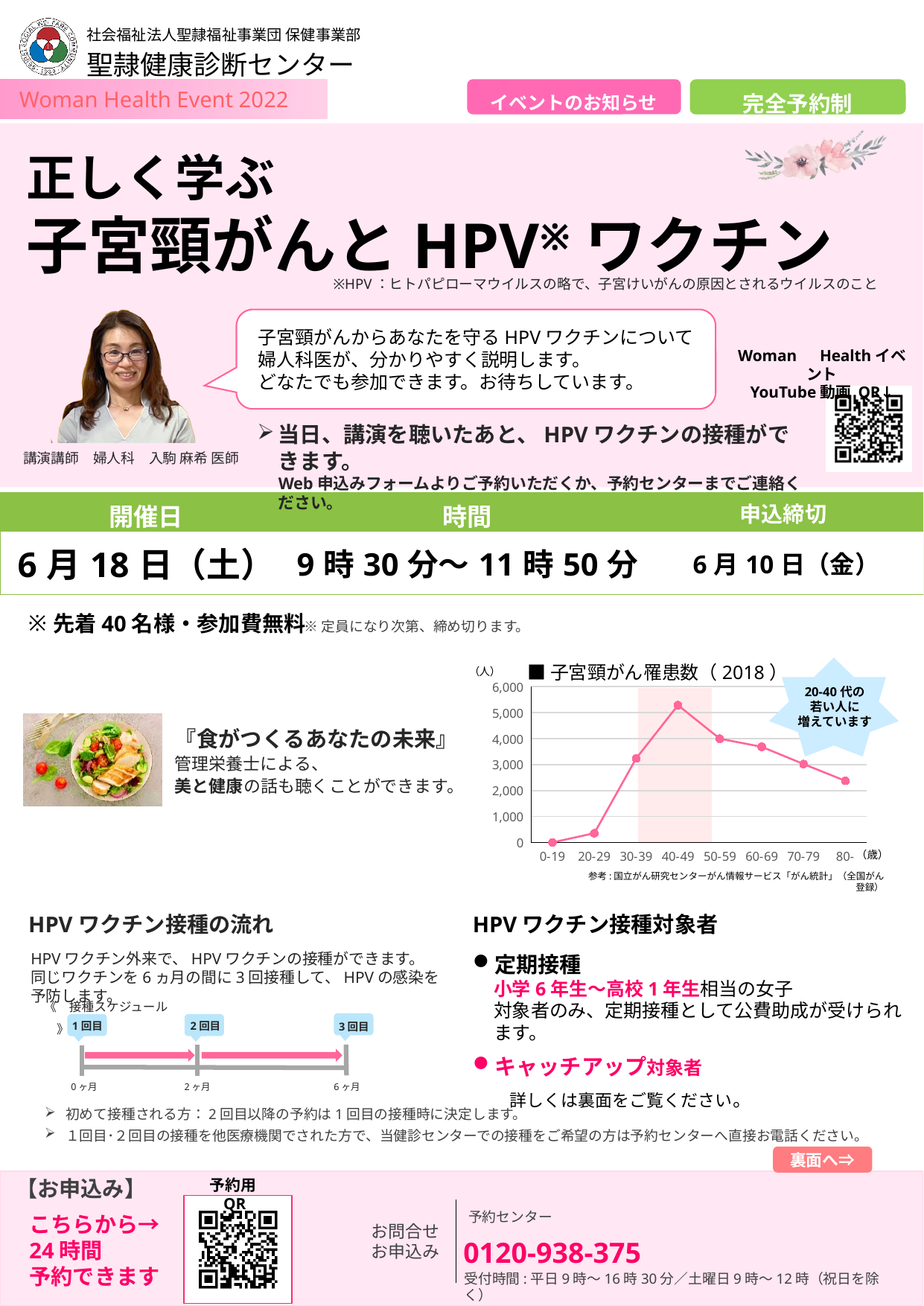
Which age group has the highest value in the 子宮頸がん罹患数（2018） chart? 40-49 Which age group has the lowest value in the 子宮頸がん罹患数（2018） chart? 0-19 In the 子宮頸がん罹患数（2018） chart, is the value for 40-49 greater or less than 5,000? greater In the 子宮頸がん罹患数（2018） chart, is the value for 80- greater or less than 2,000? greater In the 子宮頸がん罹患数（2018） chart, is the value for 20-29 greater or less than 1,000? less In the 子宮頸がん罹患数（2018） chart, do the values rise or fall from 40-49 to 80-? fall How many age groups are plotted on the x axis of the 子宮頸がん罹患数（2018） chart? 8 What unit is shown at the top of the y axis of the 子宮頸がん罹患数（2018） chart? 人 What kind of chart is the 子宮頸がん罹患数（2018） chart? line chart In the 子宮頸がん罹患数（2018） chart, which is larger, the value for 60-69 or the value for 70-79? 60-69 In the 子宮頸がん罹患数（2018） chart, which is larger, the value for 40-49 or the value for 50-59? 40-49